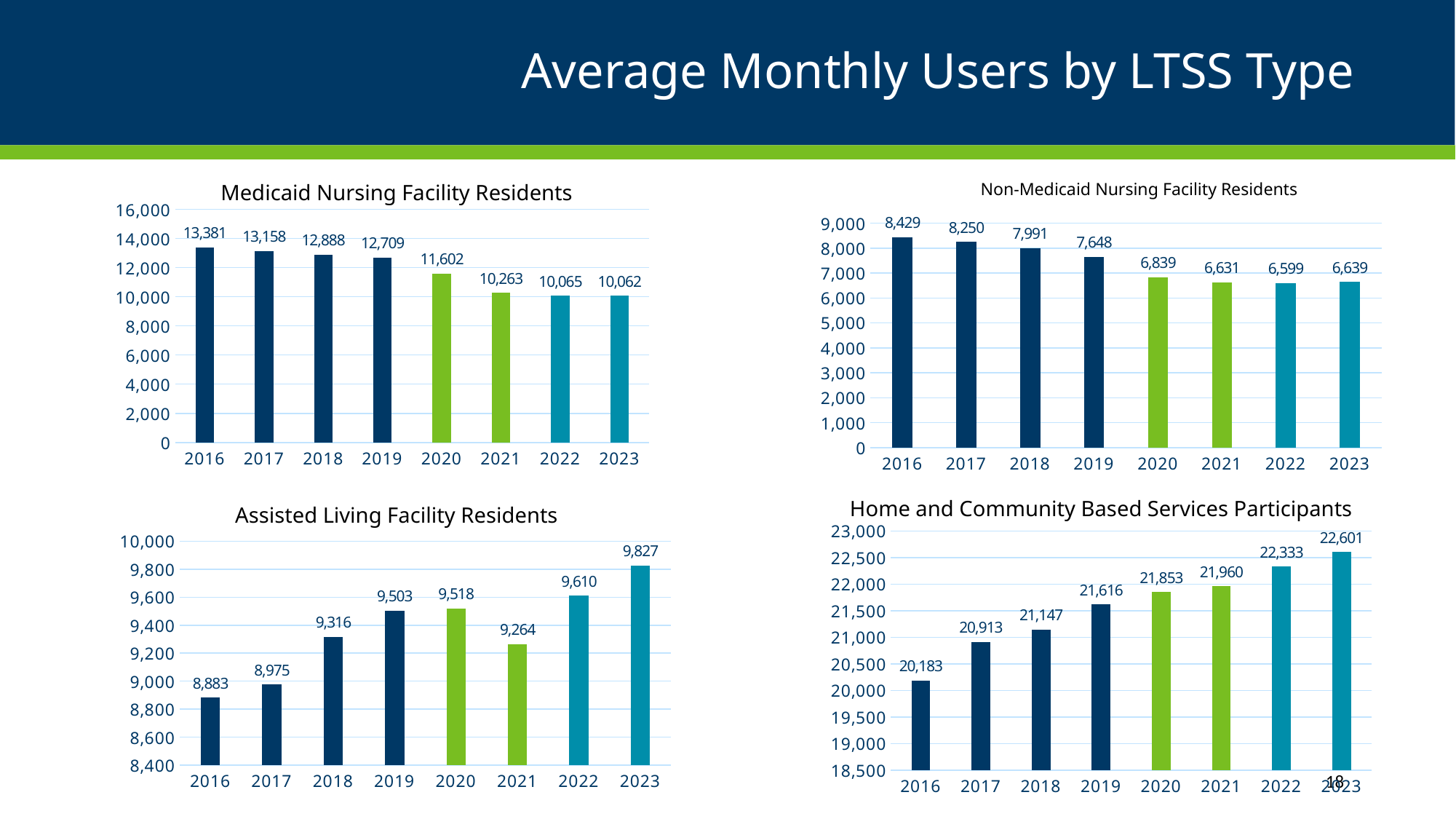
In the Home and Community Based Services Participants chart, what is the difference between the 2023 and 2016 values? 2,418 How many years are shown on the x axis of the Medicaid Nursing Facility Residents chart? 8 In the Medicaid Nursing Facility Residents chart, what is the value for 2020? 11,602 In the Home and Community Based Services Participants chart, what is the value for 2022? 22,333 In the Assisted Living Facility Residents chart, what is the value for 2021? 9,264 In the Assisted Living Facility Residents chart, is the value for 2019 larger or smaller than the value for 2020? smaller In the Home and Community Based Services Participants chart, do the values generally rise or fall from 2016 to 2023? rise In the Medicaid Nursing Facility Residents chart, which year has the highest value? 2016 In the Non-Medicaid Nursing Facility Residents chart, what is the value for 2019? 7,648 In the Non-Medicaid Nursing Facility Residents chart, which year has the lowest value? 2022 In the Assisted Living Facility Residents chart, which year has the highest value? 2023 In the Non-Medicaid Nursing Facility Residents chart, what is the difference between the 2016 and 2023 values? 1,790